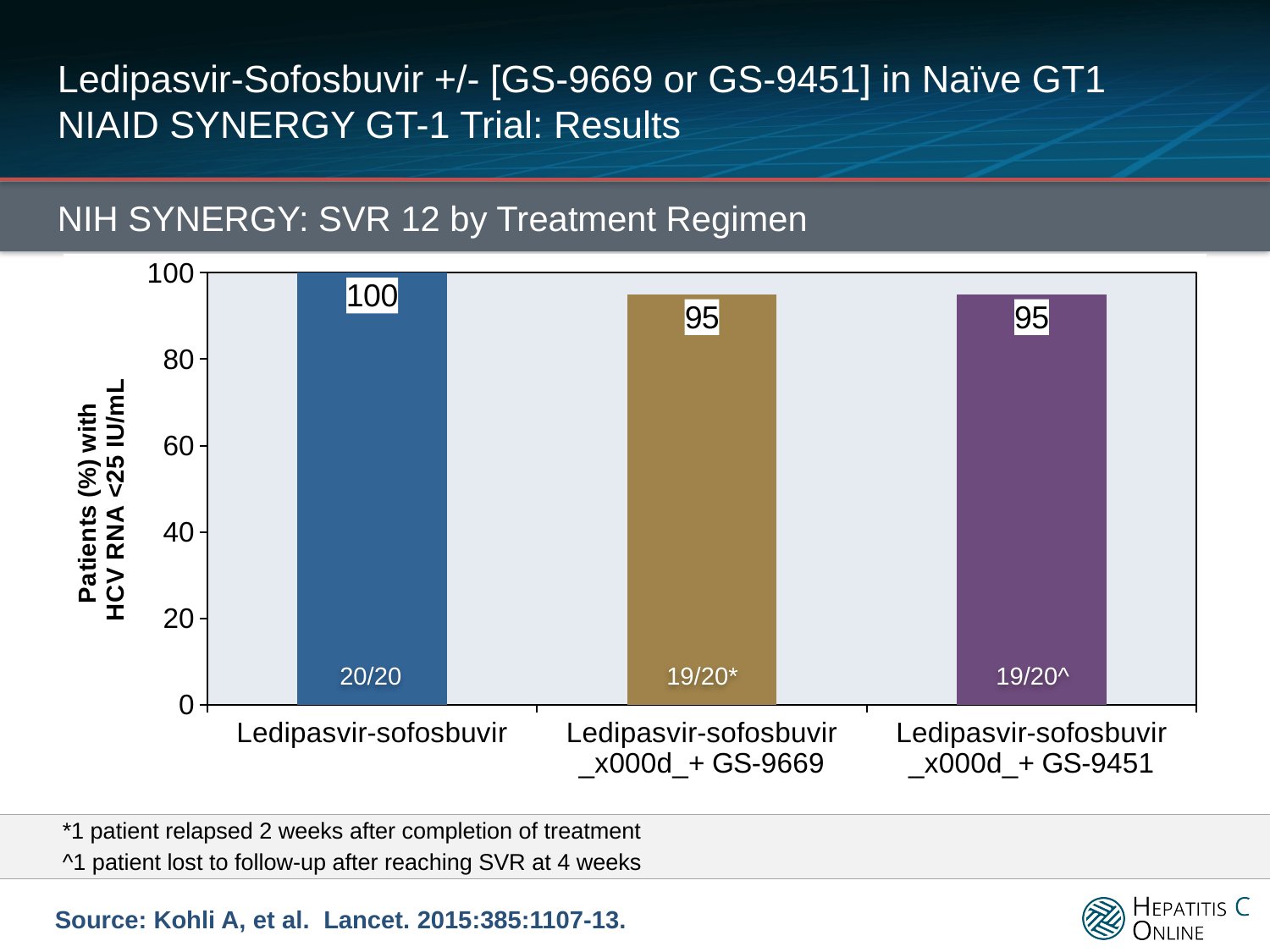
Which treatment regimen has the highest SVR 12 value? Ledipasvir-sofosbuvir What kind of chart is shown on the slide? Bar chart What is the SVR 12 value for Ledipasvir-sofosbuvir + GS-9451? 95 What is the SVR 12 value for Ledipasvir-sofosbuvir alone? 100 Which is larger, the value for Ledipasvir-sofosbuvir alone or for Ledipasvir-sofosbuvir + GS-9451? Ledipasvir-sofosbuvir alone How many treatment regimens are shown in the chart? 3 Is the value for Ledipasvir-sofosbuvir + GS-9669 greater or less than 80? greater What is the difference between the SVR 12 value for Ledipasvir-sofosbuvir alone and for Ledipasvir-sofosbuvir + GS-9669? 5 What fraction of patients is printed on the bar for Ledipasvir-sofosbuvir alone? 20/20 What fraction of patients is printed on the bar for Ledipasvir-sofosbuvir + GS-9669? 19/20* What is the SVR 12 value for Ledipasvir-sofosbuvir + GS-9669? 95 What is the title of the chart? NIH SYNERGY: SVR 12 by Treatment Regimen